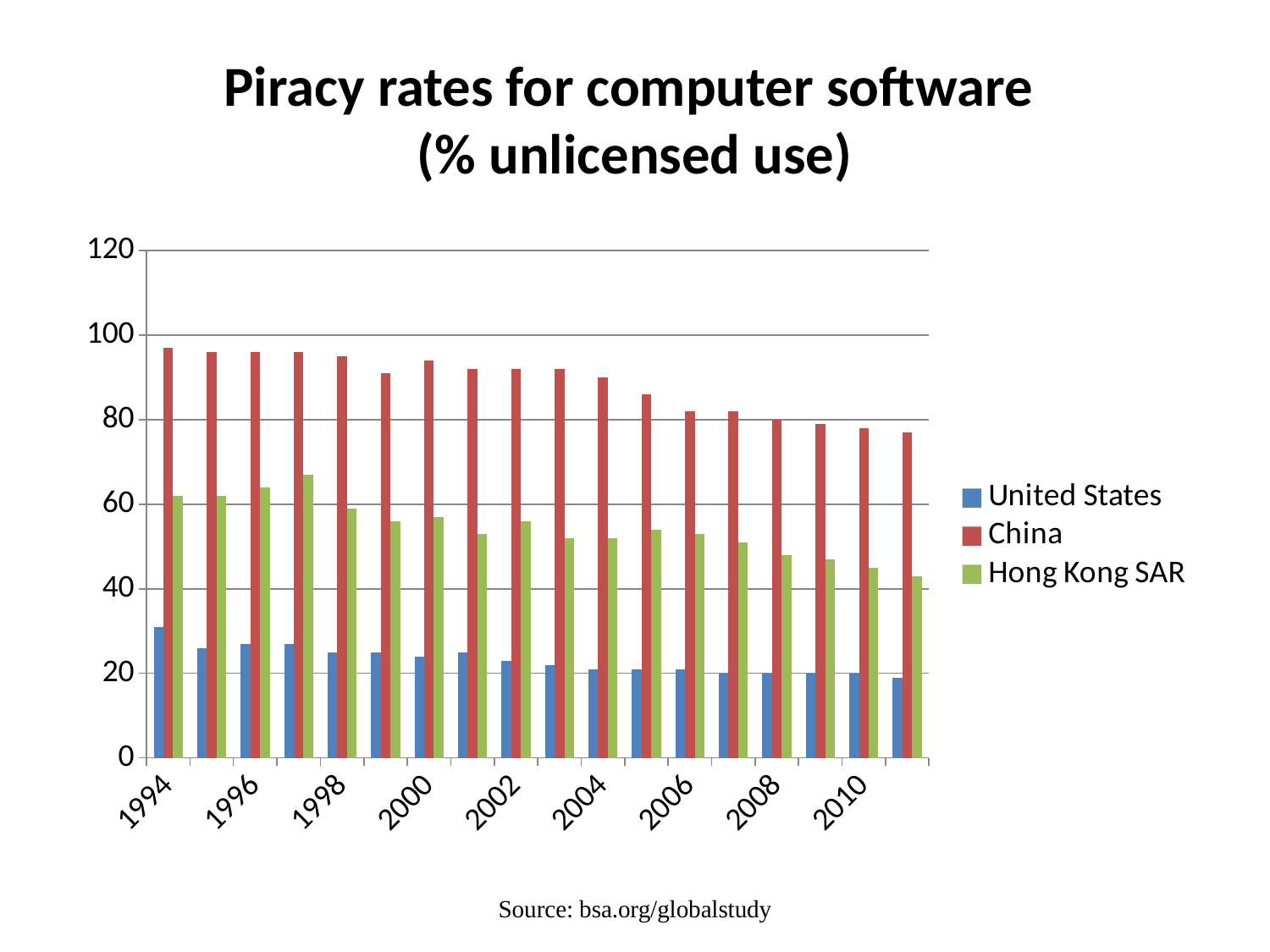
Is the value for the United States in 2010 greater or less than 40? less What is the title of the chart? Piracy rates for computer software (% unlicensed use) Which series are listed in the legend? United States, China, Hong Kong SAR Is the value for China in 2004 greater or less than 80? greater How many series does the legend list? 3 What kind of chart is shown on the slide? bar chart Which series has the lowest value in 2008? United States Is the value for the United States in 1994 greater or less than 20? greater Which is larger in 2010, the value for Hong Kong SAR or the value for the United States? Hong Kong SAR Which series has the highest value in 2000? China